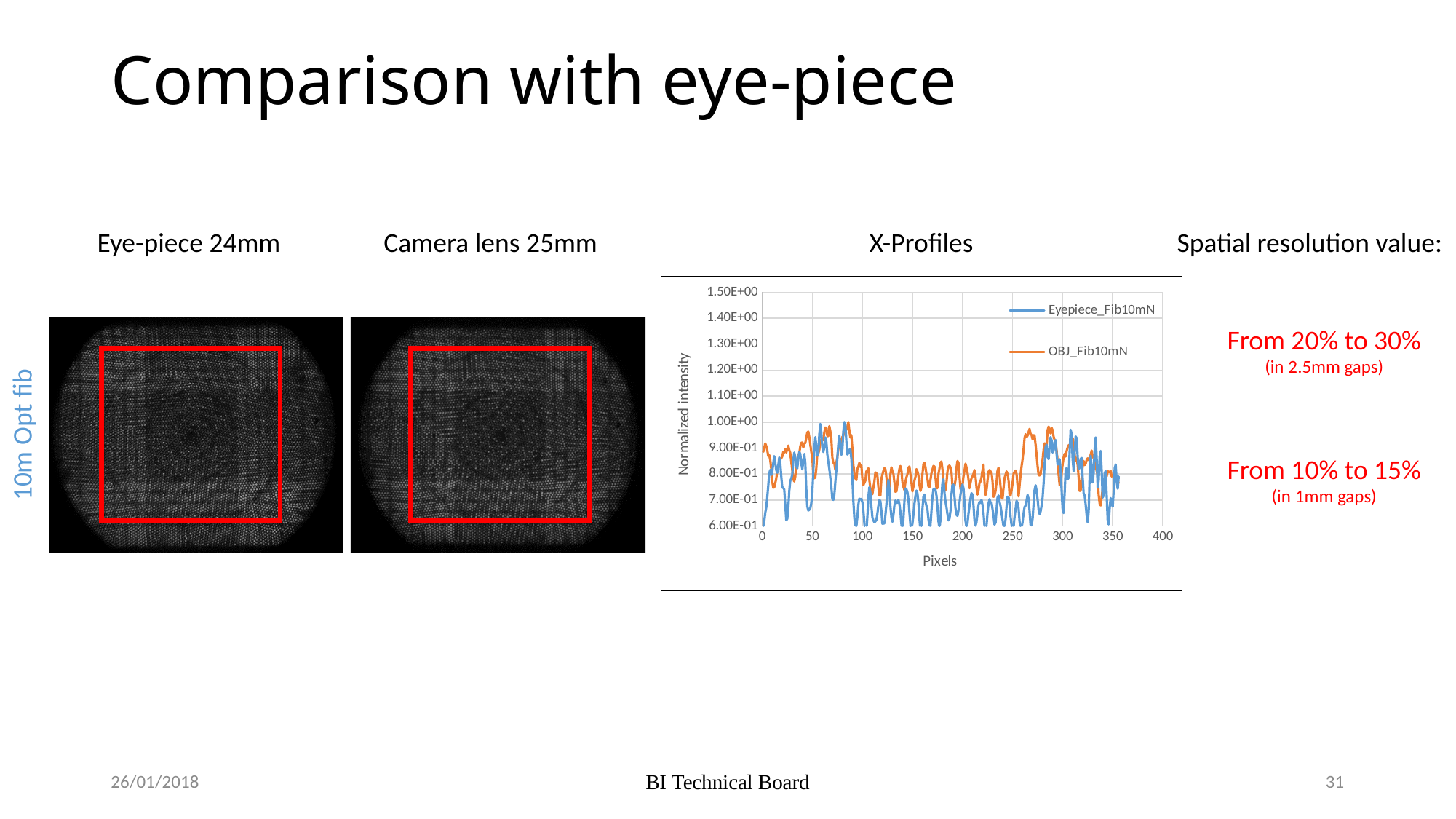
In the X-Profiles chart, between pixels 100 and 250, which series has the higher values, Eyepiece_Fib10mN or OBJ_Fib10mN? OBJ_Fib10mN What kind of chart is the X-Profiles chart? line chart In the X-Profiles chart, is the highest value reached by the OBJ_Fib10mN series greater or less than 1.20E+00? less In the X-Profiles chart, is the value of Eyepiece_Fib10mN at pixel 150 greater or less than 8.00E-01? less In the X-Profiles chart, which series is drawn in orange? OBJ_Fib10mN What is the label of the vertical axis of the X-Profiles chart? Normalized intensity How many series does the legend of the X-Profiles chart list? 2 In the X-Profiles chart, is the value of OBJ_Fib10mN at pixel 150 greater or less than 9.00E-01? less